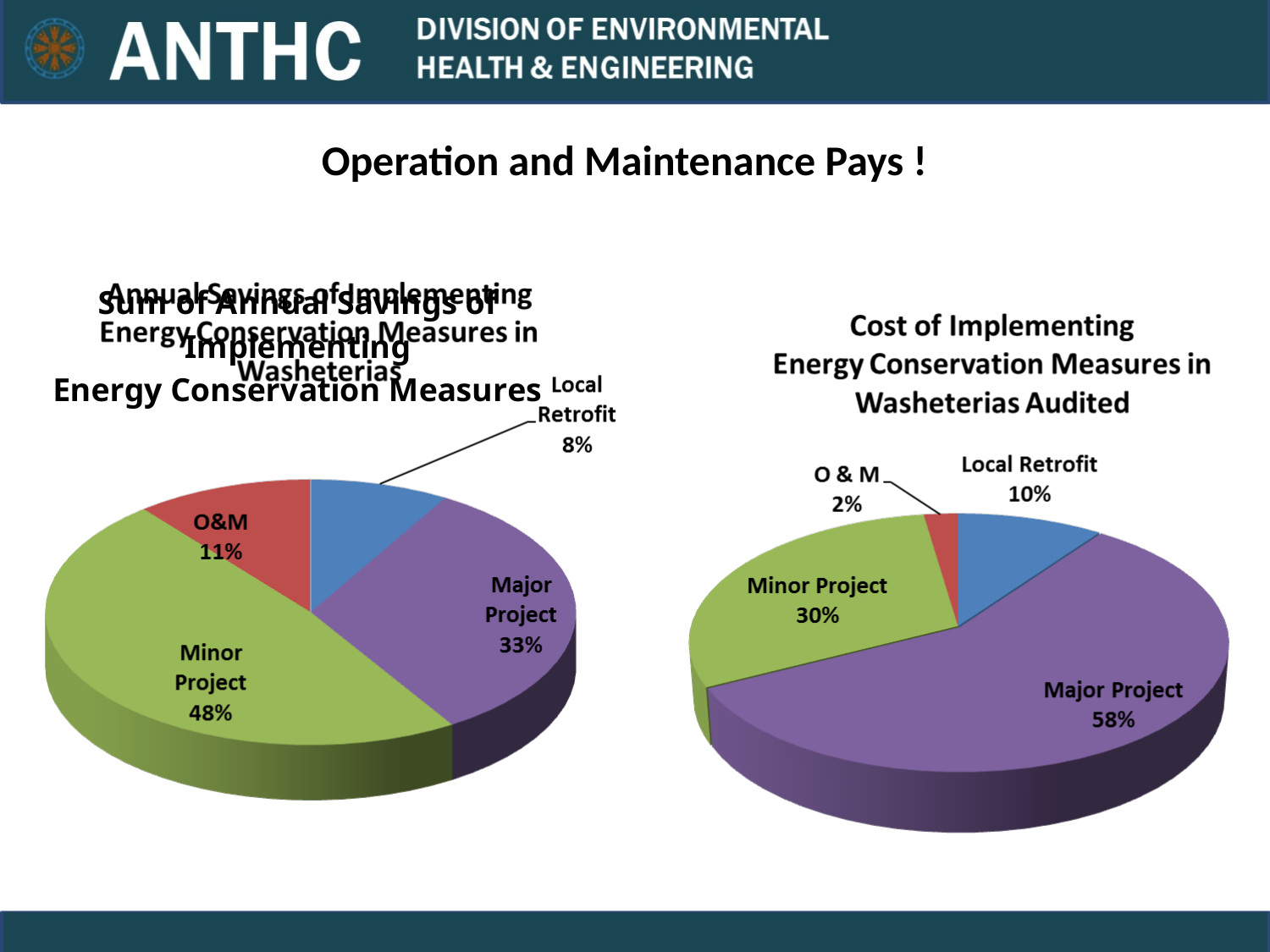
What is the title of the right chart on the slide? Cost of Implementing Energy Conservation Measures in Washeterias Audited What type of chart is the left chart on the slide? Pie chart In the left pie chart, which category has the smallest share? Local Retrofit In the right pie chart (Cost of Implementing Energy Conservation Measures in Washeterias Audited), what share does O & M have? 2% In the right pie chart (Cost of Implementing Energy Conservation Measures in Washeterias Audited), what share does Major Project have? 58% How many slices does the right pie chart (Cost of Implementing Energy Conservation Measures in Washeterias Audited) have? 4 In the right pie chart (Cost of Implementing Energy Conservation Measures in Washeterias Audited), what is the difference in percentage points between Major Project and Minor Project? 28 In the left pie chart, what share does O&M have? 11% In the left pie chart, what share does Minor Project have? 48% In the left pie chart, which is larger, Major Project or Minor Project? Minor Project In the left pie chart, which category has the largest share? Minor Project In the right pie chart (Cost of Implementing Energy Conservation Measures in Washeterias Audited), which category has the smallest share? O & M